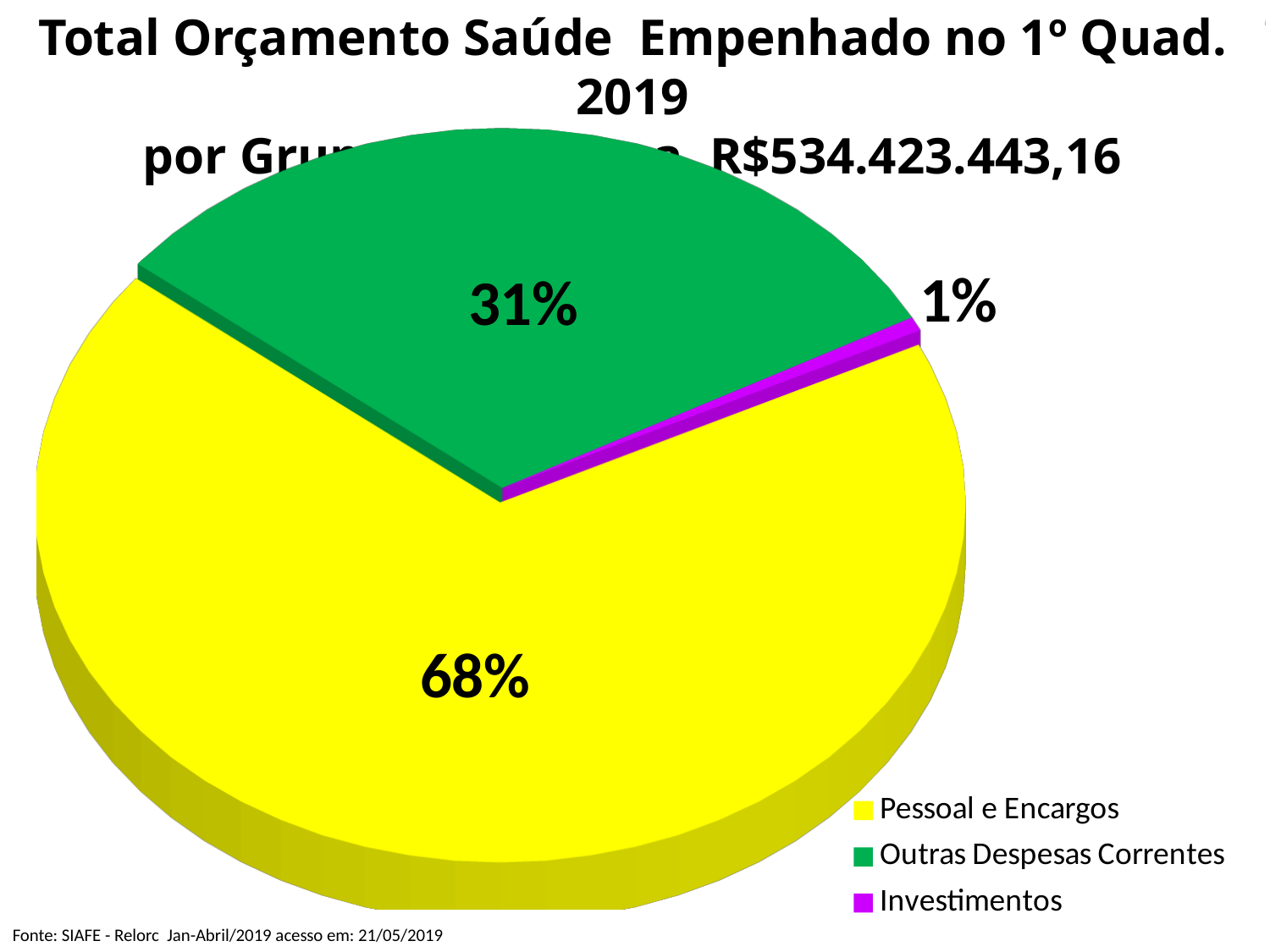
Is the share for Outras Despesas Correntes greater or less than 50%? less What share of the pie does Investimentos represent? 1% Which category has the smallest slice of the pie? Investimentos What is the difference in percentage points between Pessoal e Encargos and Outras Despesas Correntes? 37 Which category has the largest slice of the pie? Pessoal e Encargos What kind of chart is shown on the slide? pie chart How many categories does the pie chart show? 3 What share of the pie does Outras Despesas Correntes represent? 31% What share of the pie does Pessoal e Encargos represent? 68% Which is larger, the slice for Outras Despesas Correntes or the slice for Investimentos? Outras Despesas Correntes What colour is the slice for Investimentos? magenta What total amount in R$ is shown in the chart title? R$534.423.443,16